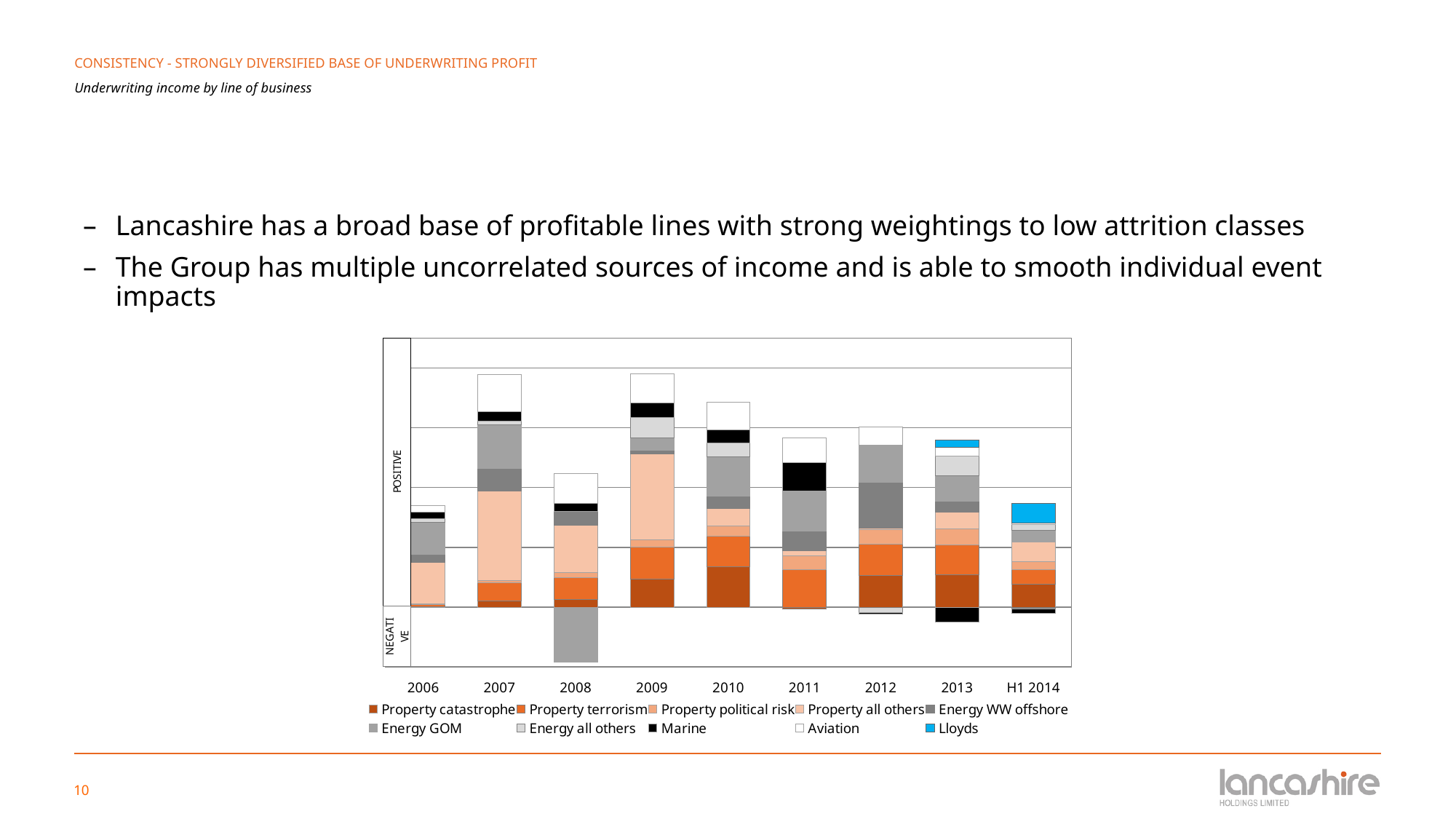
How many periods are shown along the x axis of the chart? 9 What is the subtitle describing the chart on the slide? Underwriting income by line of business What is the first period shown on the x axis of the chart? 2006 Which year has the largest negative segment in the chart? 2008 Is the total positive stack for 2007 larger or smaller than the total positive stack for 2006? Larger Which series is shown in black in the chart's legend? Marine How many series does the chart's legend list? 10 What kind of chart is shown on the slide? Stacked bar chart Is the positive stack for 2009 taller or shorter than the positive stack for 2011? Taller